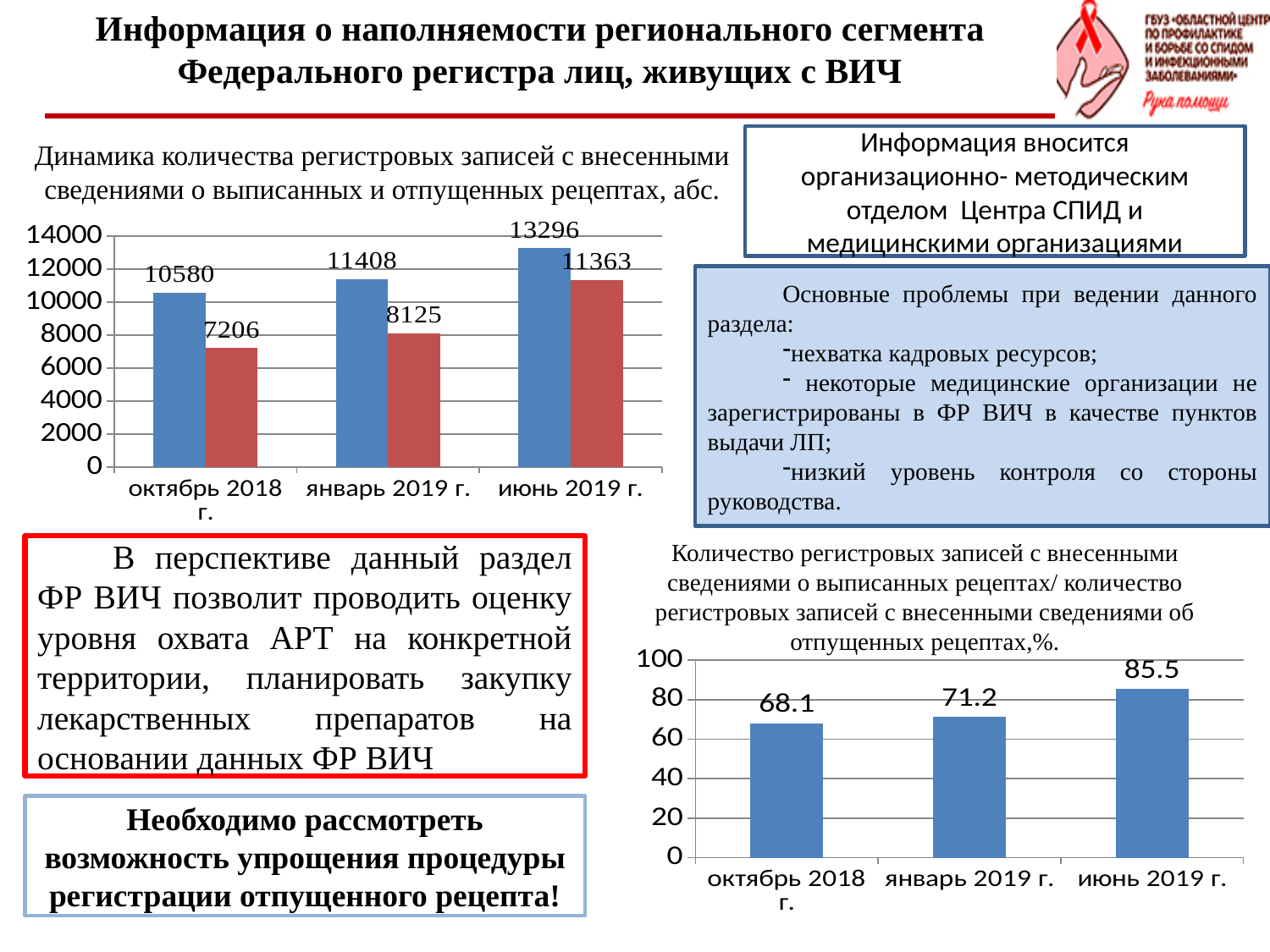
On the left chart (Динамика количества регистровых записей...), which period has the highest blue bar? июнь 2019 г. On the bottom-right chart (Количество регистровых записей ... %), what is the difference between июнь 2019 г. and октябрь 2018 г.? 17.4 On the bottom-right chart (Количество регистровых записей ... %), which period has the highest value? июнь 2019 г. On the left chart (Динамика количества регистровых записей...), what is the value of the blue bar for октябрь 2018 г.? 10580 On the left chart (Динамика количества регистровых записей...), which period has the lowest red bar? октябрь 2018 г. On the left chart (Динамика количества регистровых записей...), how many periods are shown on the x axis? 3 On the left chart (Динамика количества регистровых записей...), what is the value of the red bar for июнь 2019 г.? 11363 On the bottom-right chart (Количество регистровых записей ... %), what is the value for январь 2019 г.? 71.2 On the left chart (Динамика количества регистровых записей...), do the red bar values rise or fall from октябрь 2018 г. to июнь 2019 г.? rise On the left chart (Динамика количества регистровых записей...), what is the difference between the blue and red bars for октябрь 2018 г.? 3374 On the left chart (Динамика количества регистровых записей...), what is the value of the red bar for январь 2019 г.? 8125 What type of chart is the bottom-right chart (Количество регистровых записей ... %)? bar chart